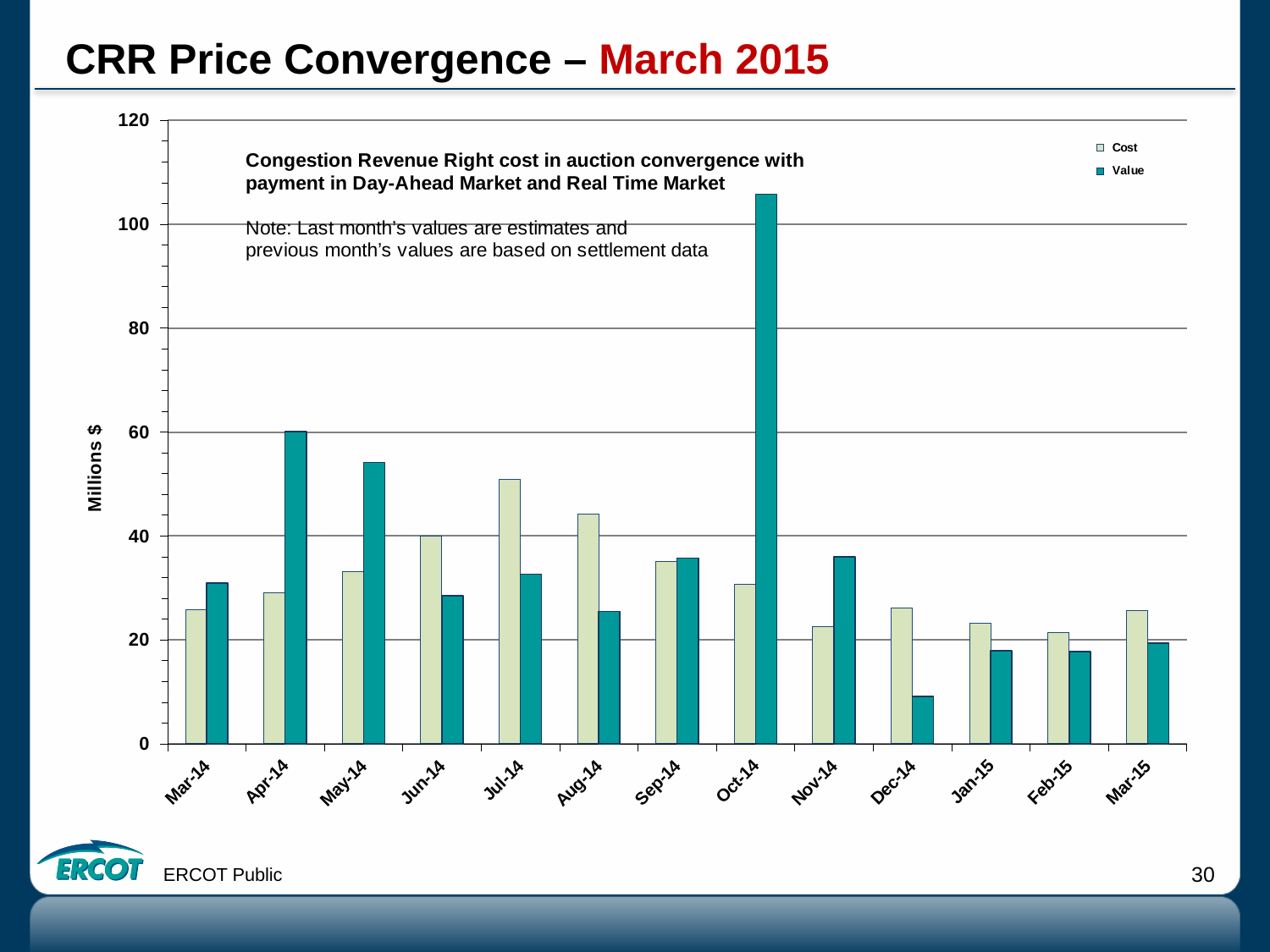
Is the Value for Dec-14 greater or less than 20? less What kind of chart is shown on the slide? bar chart For Apr-14, which is larger, Cost or Value? Value For Aug-14, which is larger, Cost or Value? Cost Which month has the highest Value bar? Oct-14 What is the label on the y axis? Millions $ Is the Cost for Jul-14 greater or less than 40? greater How many series does the legend list? 2 Which month has the lowest Value bar? Dec-14 Which month has the highest Cost bar? Jul-14 Is the Value for Oct-14 greater or less than 100? greater How many months are shown on the x axis? 13